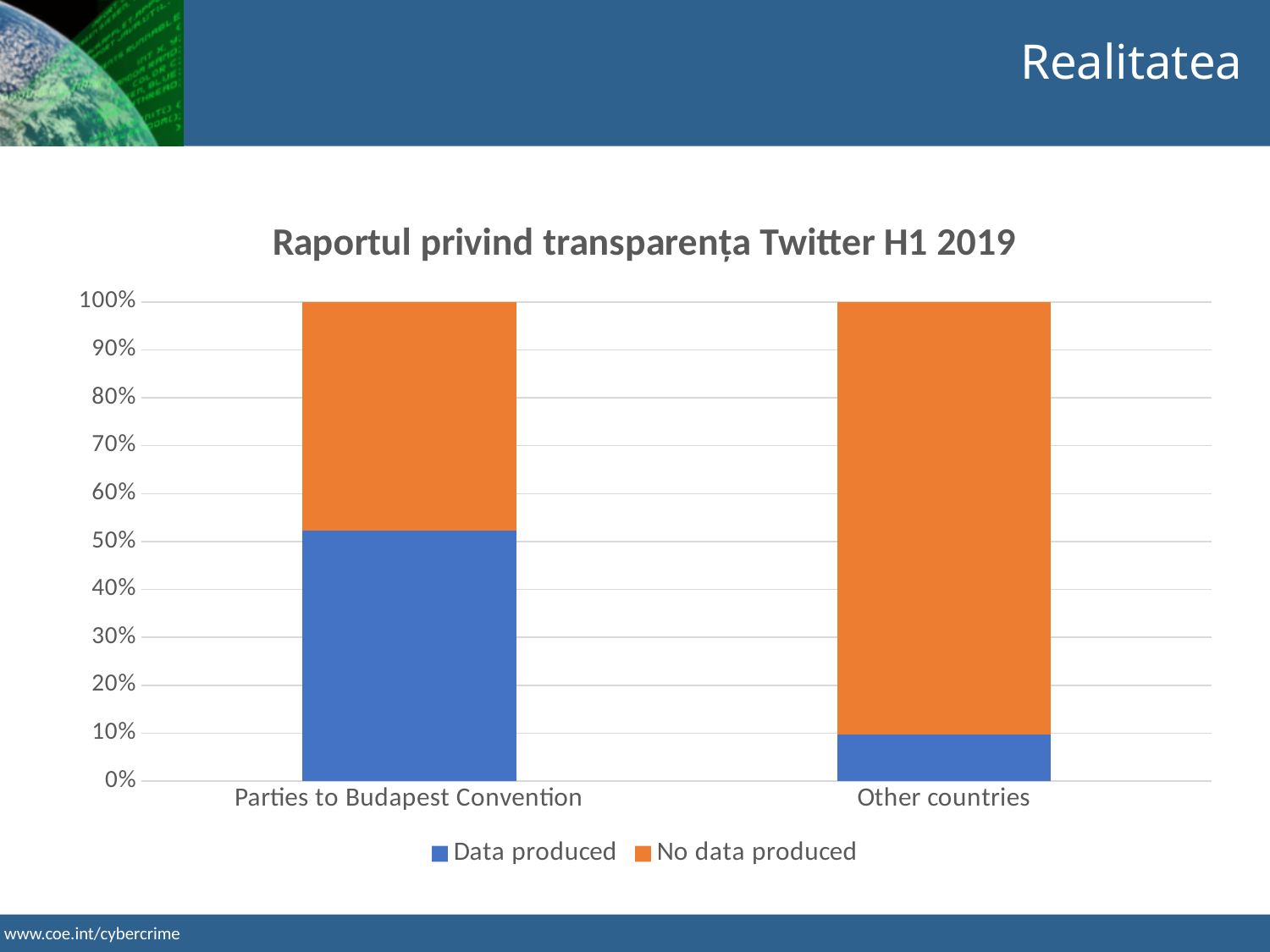
Is the Data produced share for Parties to Budapest Convention greater or less than 40%? greater What is the title of the chart? Raportul privind transparența Twitter H1 2019 Which is larger: the No data produced share for Other countries or the No data produced share for Parties to Budapest Convention? Other countries Is the No data produced share for Other countries greater or less than 80%? greater Is the Data produced share for Other countries greater or less than 20%? less What kind of chart is shown on the slide? Stacked bar chart What is the total of the stacked bar for Other countries? 100% Which category has the lower share of Data produced? Other countries How many categories are shown on the x axis of the chart? 2 Which category has the higher share of Data produced? Parties to Budapest Convention Which series is shown in orange in the chart? No data produced How many series does the chart's legend list? 2